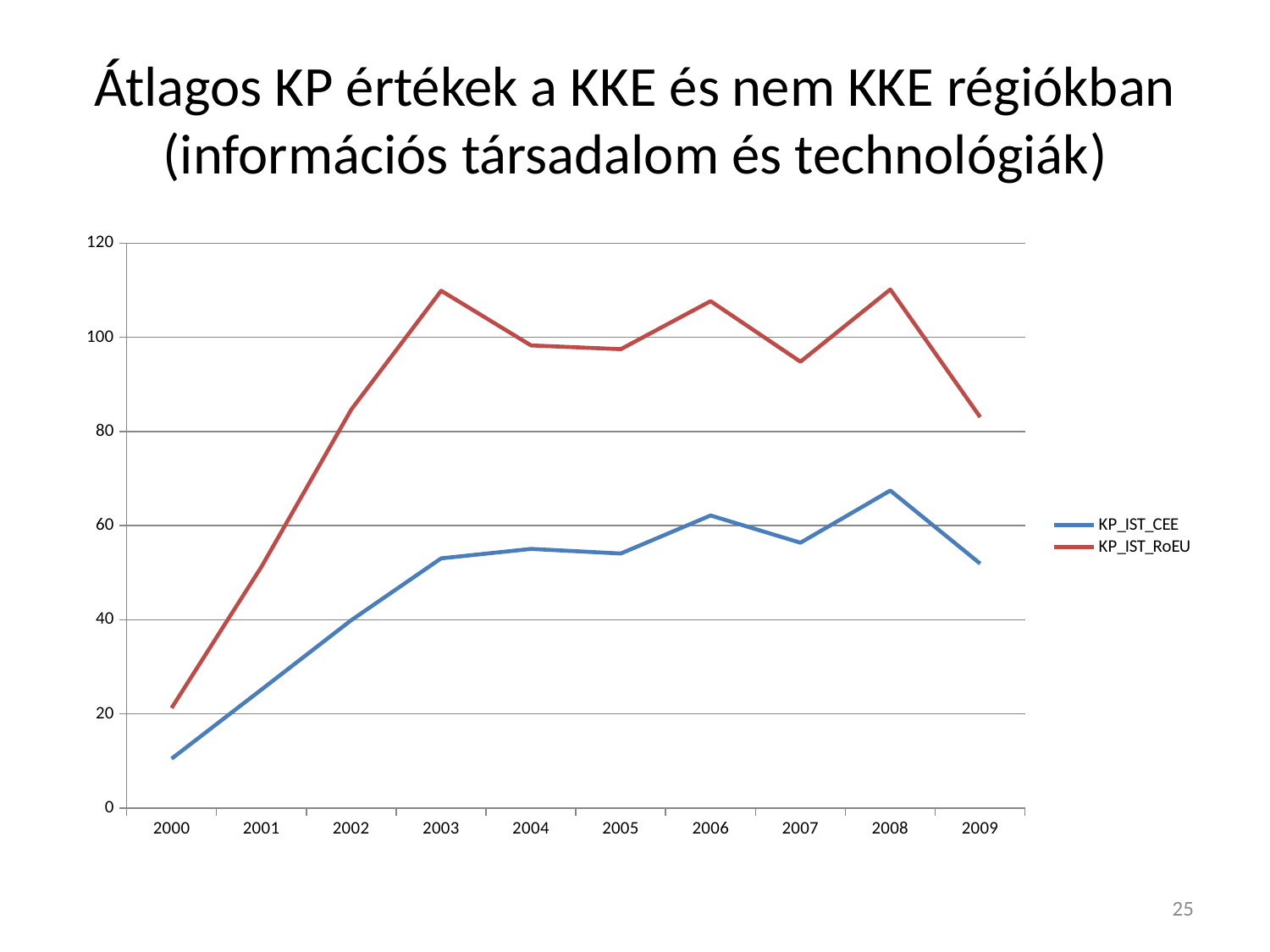
Which series is shown in red? KP_IST_RoEU Is the value for KP_IST_CEE in 2008 greater or less than 60? greater How many series does the legend list? 2 Is the value for KP_IST_CEE in 2000 greater or less than 20? less In 2005, which series has the higher value, KP_IST_CEE or KP_IST_RoEU? KP_IST_RoEU Is the value for KP_IST_RoEU in 2007 greater or less than 100? less In which year does KP_IST_CEE reach its highest value? 2008 What kind of chart is shown on the slide? line chart Between 2000 and 2003, do the values for KP_IST_RoEU rise or fall? rise How many years are plotted along the x axis? 10 In which year does KP_IST_CEE have its lowest value? 2000